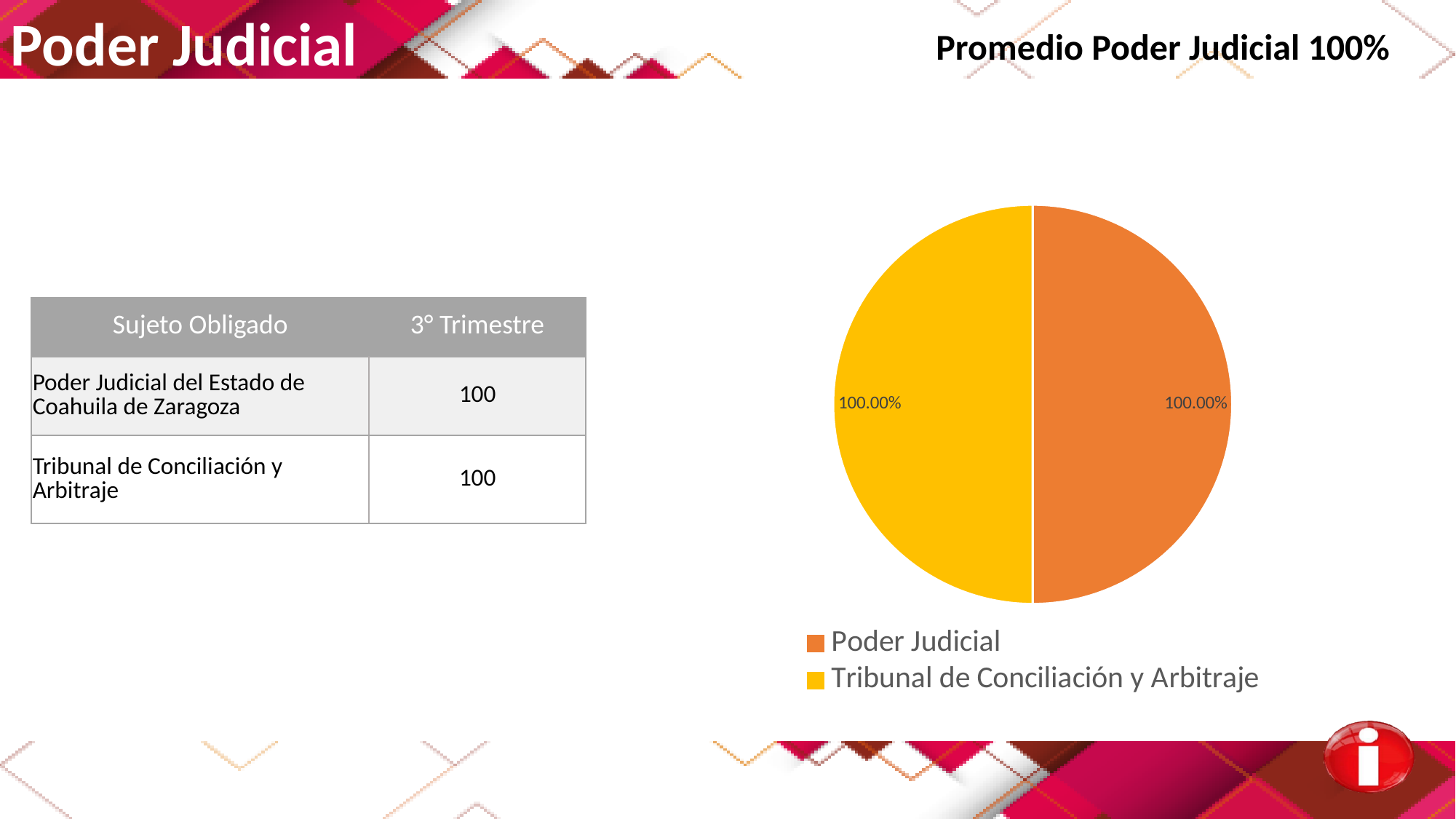
What kind of chart is shown on the slide? pie chart Is the data label on the Tribunal de Conciliación y Arbitraje slice greater or less than 50%? greater What is the data label shown on the Poder Judicial slice of the pie chart? 100.00% Which legend entry is listed first in the pie chart's legend? Poder Judicial What is the data label shown on the Tribunal de Conciliación y Arbitraje slice of the pie chart? 100.00% Is the data label on the Poder Judicial slice greater or less than 50%? greater What colour is the Poder Judicial slice in the pie chart? orange How many entries does the legend of the pie chart list? 2 How many slices does the pie chart have? 2 What colour is the Tribunal de Conciliación y Arbitraje slice in the pie chart? yellow